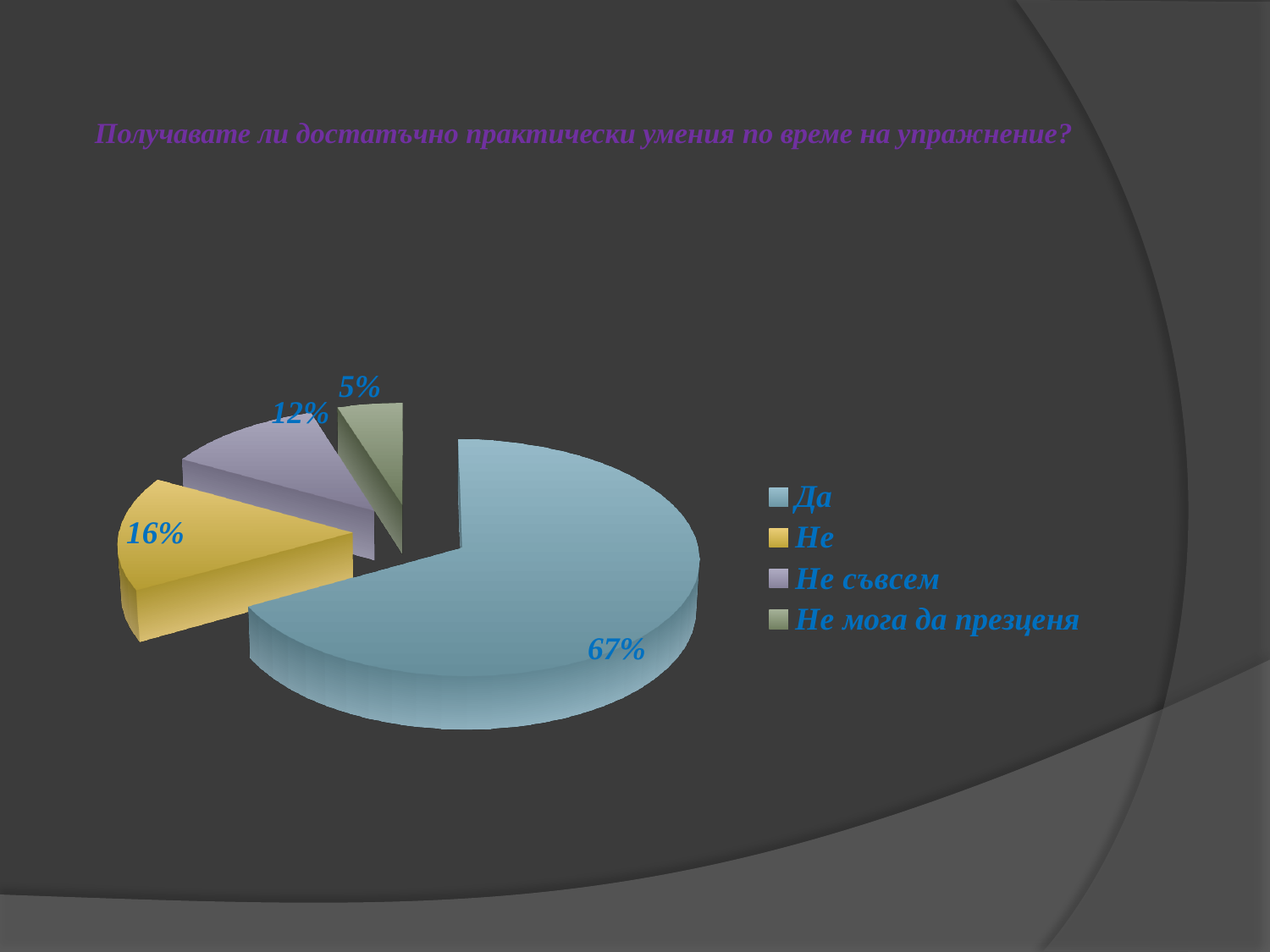
What percentage is shown for "Не мога да презценя"? 5% What percentage is shown for "Да"? 67% Which category has the smallest slice of the pie? Не мога да презценя What kind of chart is shown on the slide? pie chart What is the difference in percentage points between "Да" and "Не"? 51 Which category has the largest slice of the pie? Да What is the title of the chart? Получавате ли достатъчно практически умения по време на упражнение? What colour is the slice for "Не"? yellow Which is larger, the share for "Не" or the share for "Не съвсем"? Не What percentage is shown for "Не съвсем"? 12% How many categories does the pie chart have? 4 What percentage is shown for "Не"? 16%